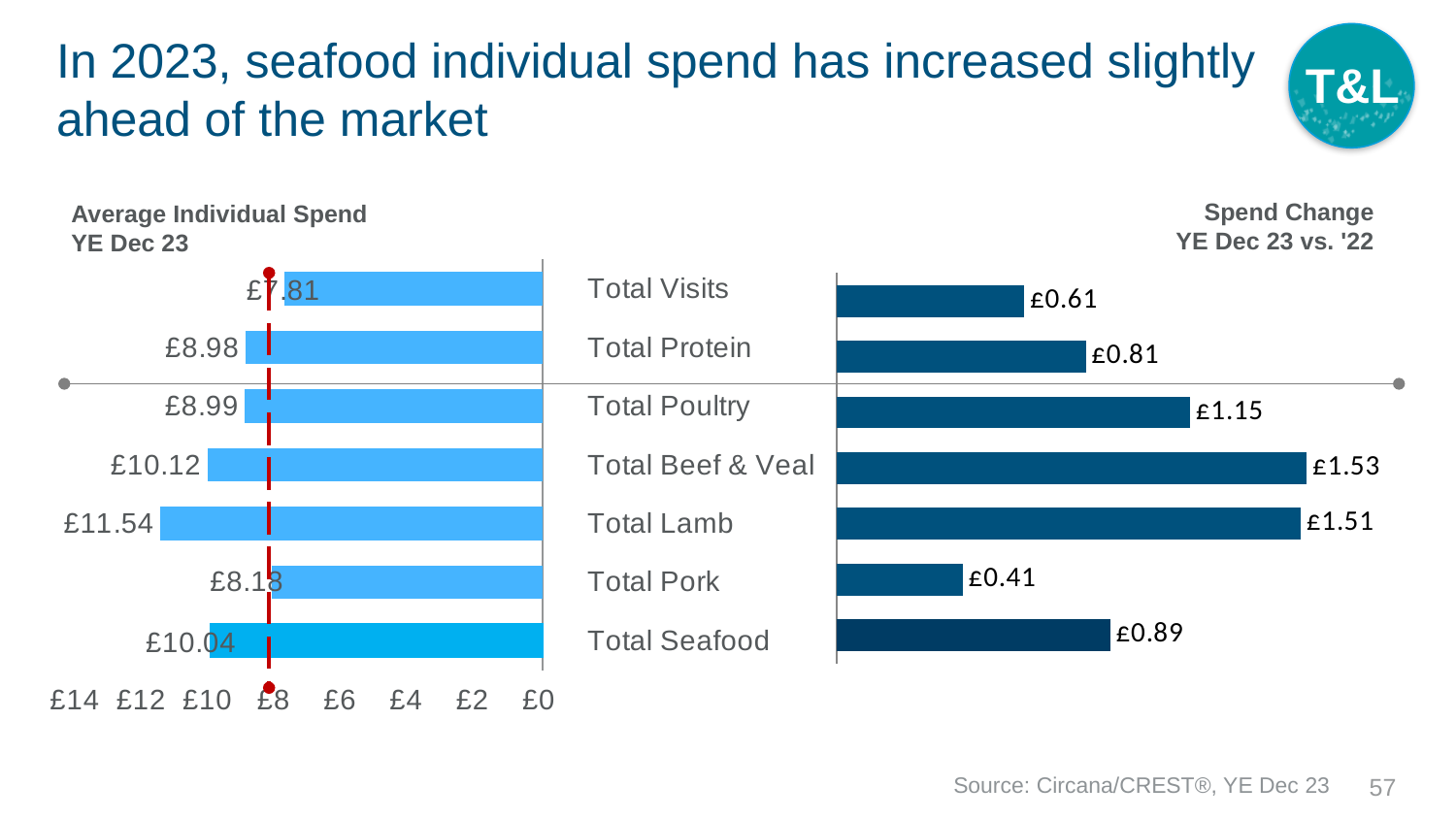
In the Average Individual Spend YE Dec 23 chart, what is the difference between Total Lamb and Total Beef & Veal? £1.42 How many categories are shown in the Average Individual Spend YE Dec 23 chart? 7 What kind of chart is the Spend Change YE Dec 23 vs. '22 chart? Bar chart In the Spend Change YE Dec 23 vs. '22 chart, which category has the highest value? Total Beef & Veal In the Average Individual Spend YE Dec 23 chart, what is the value for Total Visits? £7.81 In the Spend Change YE Dec 23 vs. '22 chart, what is the difference between Total Seafood and Total Visits? £0.28 In the Average Individual Spend YE Dec 23 chart, what is the value for Total Seafood? £10.04 In the Spend Change YE Dec 23 vs. '22 chart, which is larger: Total Poultry or Total Protein? Total Poultry In the Spend Change YE Dec 23 vs. '22 chart, which category has the lowest value? Total Pork In the Average Individual Spend YE Dec 23 chart, which category has the highest value? Total Lamb In the Spend Change YE Dec 23 vs. '22 chart, what is the value for Total Seafood? £0.89 What is the title of the right-hand chart on the slide? Spend Change YE Dec 23 vs. '22